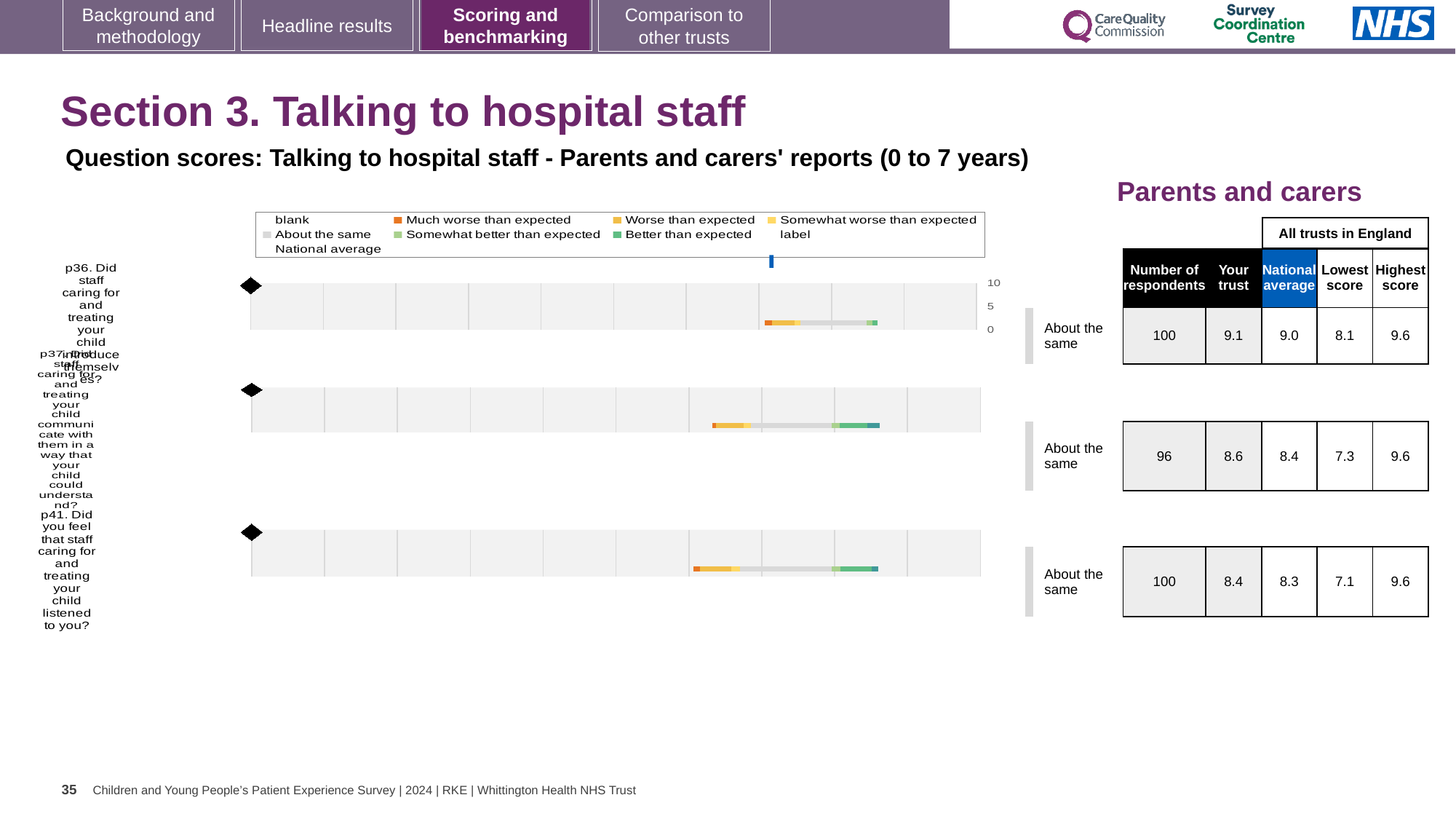
Which of the three questions has the lowest 'Your trust' score? p41 For the p36 chart, which is larger: the 'Your trust' score or the national average? Your trust Which of the three questions has the highest 'Your trust' score? p36 For the p36 chart (staff introducing themselves), what is the 'Your trust' score? 9.1 For the p37 chart, what is the difference between the 'Your trust' score and the national average? 0.2 How many question charts (rows) are shown on the slide? 3 In the chart legend, what colour represents 'Much worse than expected'? orange For the p37 chart (staff communicating in a way your child could understand), how many respondents are there? 96 What benchmark category is shown next to the p41 chart? About the same What is the maximum value shown on the chart axis? 10 What kind of chart is used for the three question rows on the slide? bar chart For the p41 chart (staff listened to you), what is the lowest score among all trusts in England? 7.1